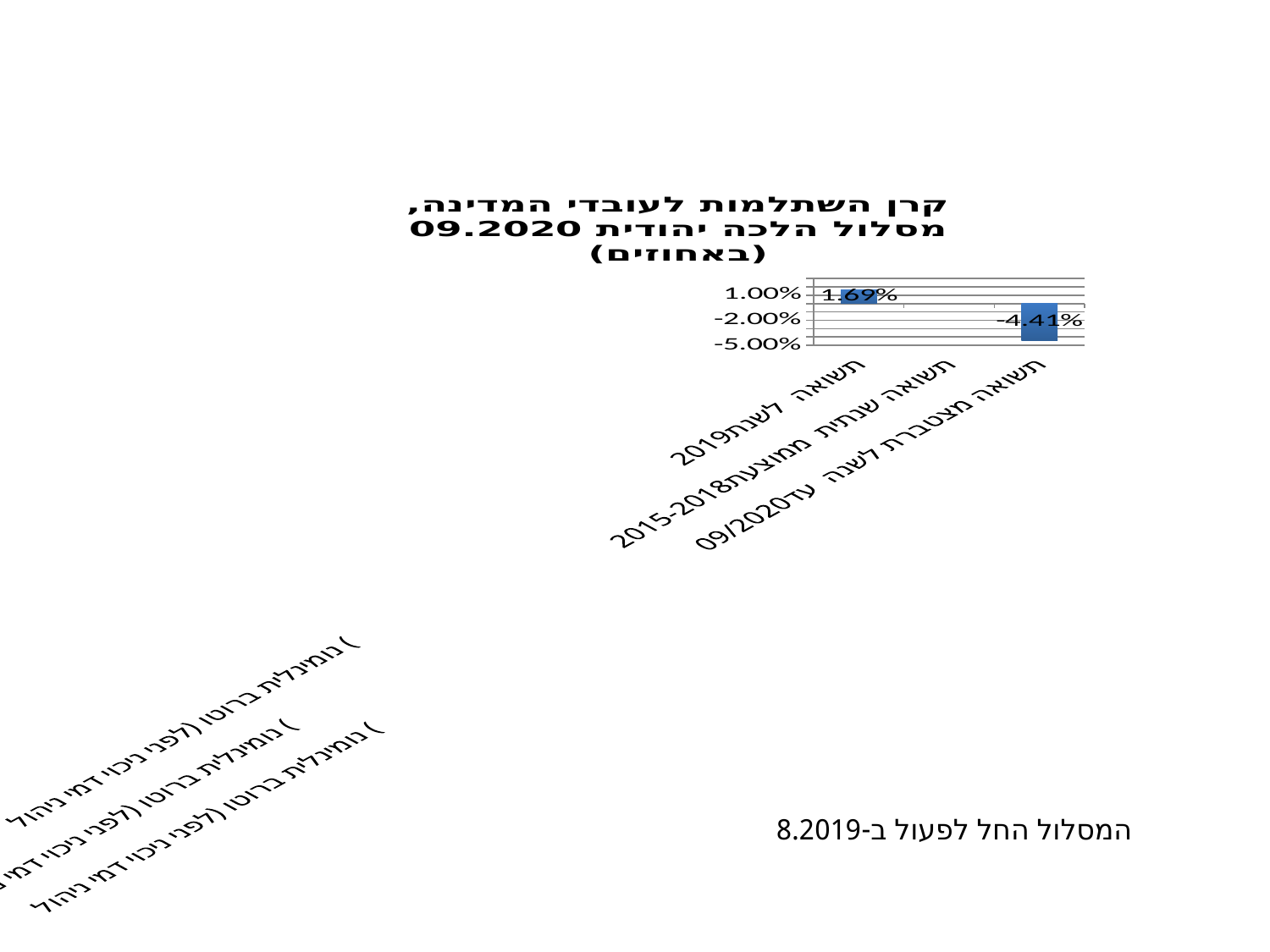
Which is larger: the value for תשואה לשנת 2019 or the value for תשואה מצטברת לשנה עד 09/2020? תשואה לשנת 2019 What is the difference between the value for תשואה לשנת 2019 and the value for תשואה מצטברת לשנה עד 09/2020? 6.10% Is the value for תשואה מצטברת לשנה עד 09/2020 greater or less than -2.00%? less Which category has the lowest value? תשואה מצטברת לשנה עד 09/2020 Which category has the highest value? תשואה לשנת 2019 What kind of chart is shown on the slide? bar chart What is the title of the chart? קרן השתלמות לעובדי המדינה, מסלול הלכה יהודית 09.2020 (באחוזים) What colour are the bars in the chart? blue How many categories are shown on the x axis of the chart? 3 Is the value for תשואה לשנת 2019 greater or less than 1.00%? greater What is the value for תשואה מצטברת לשנה עד 09/2020? -4.41% What is the value for תשואה לשנת 2019? 1.69%